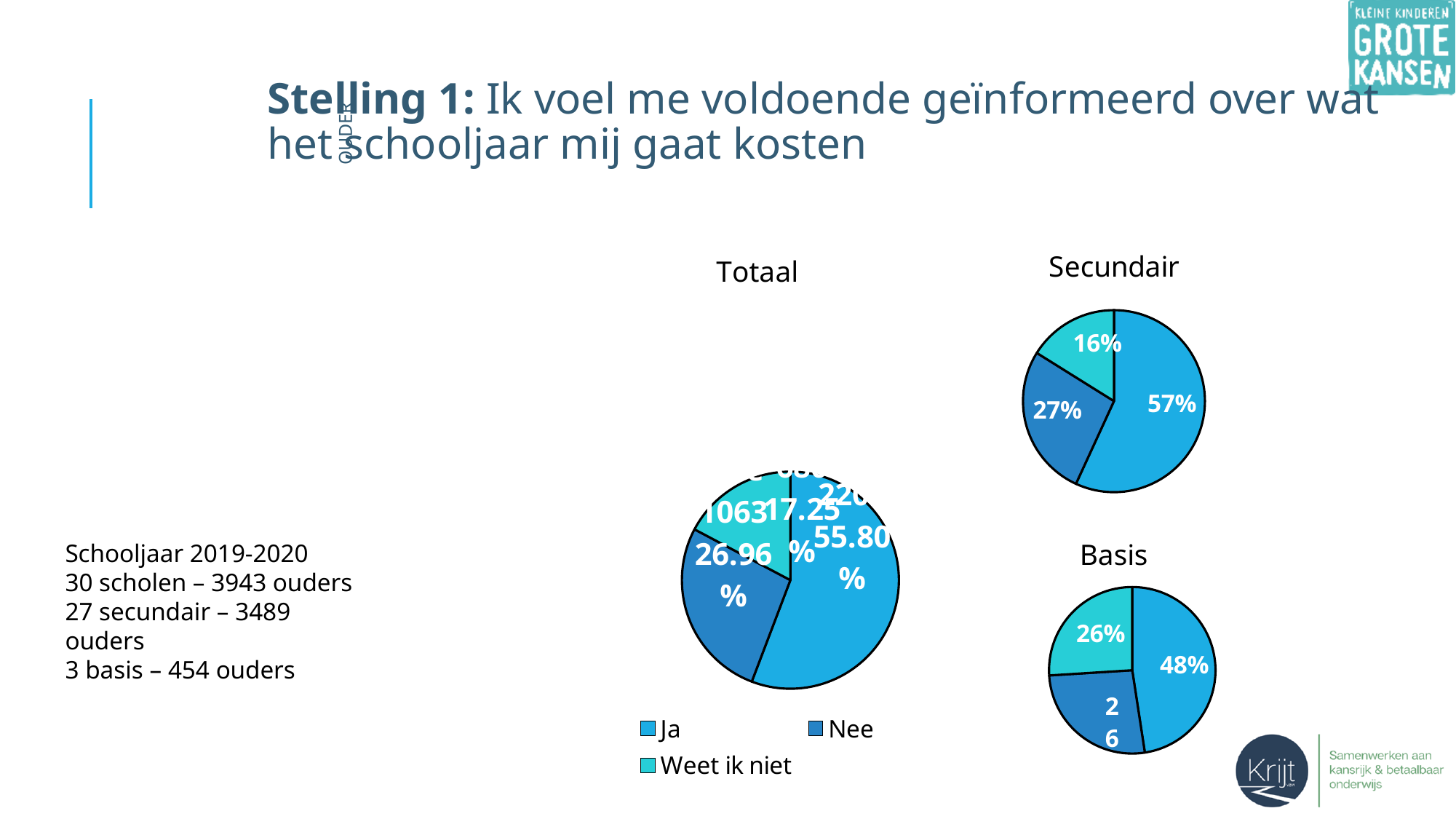
In the Totaal chart, what is the percentage for Nee? 26.96% In the Secundair chart, what is the share for Weet ik niet? 16% In the Totaal chart, what is the percentage for Ja? 55.80% In the Basis chart, what is the share for Weet ik niet? 26% In the Secundair chart, which category has the smallest share? Weet ik niet In the Secundair chart, what is the share for Ja? 57% What kind of chart is the Secundair chart? pie chart How many series does the legend list? 3 In the Basis chart, which category has the largest share? Ja In the Secundair chart, what is the share for Nee? 27% In the Basis chart, what is the share for Ja? 48% In the Secundair chart, what is the difference between the Ja share and the Nee share? 30%